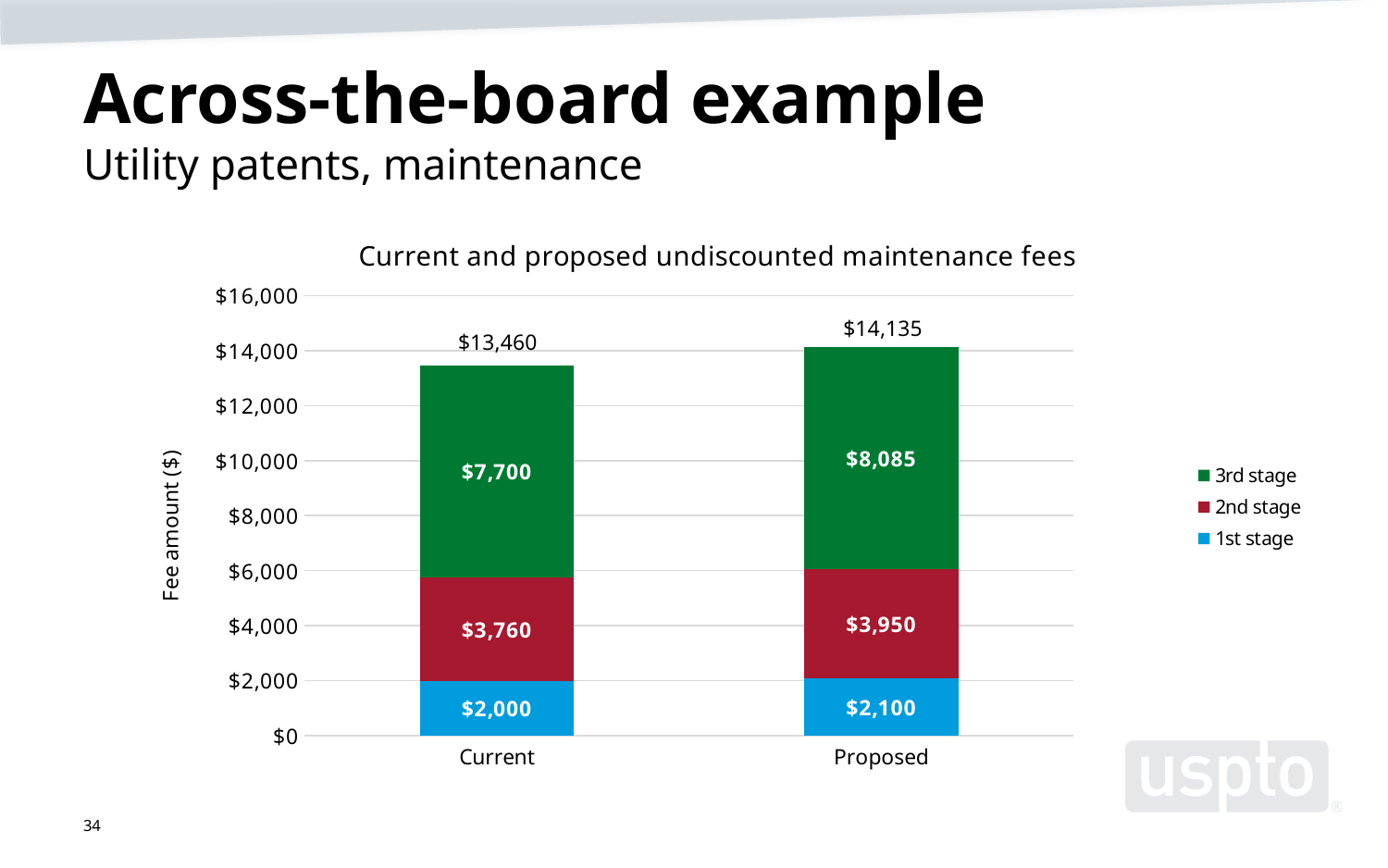
What is the title of the chart? Current and proposed undiscounted maintenance fees What kind of chart is shown on the slide? Stacked bar chart What is the difference between the Proposed and Current 3rd stage fees? $385 How many series does the legend list? 3 What is the 3rd stage fee for the Current bar? $7,700 What is the 1st stage fee for the Proposed bar? $2,100 Which is larger, the Current 2nd stage fee or the Proposed 2nd stage fee? Proposed 2nd stage fee What is the difference between the Proposed and Current total maintenance fees? $675 Which stage has the highest fee in the Proposed bar? 3rd stage What is the total of the Proposed stacked bar? $14,135 What is the 2nd stage fee for the Proposed bar? $3,950 What is the total of the Current stacked bar? $13,460